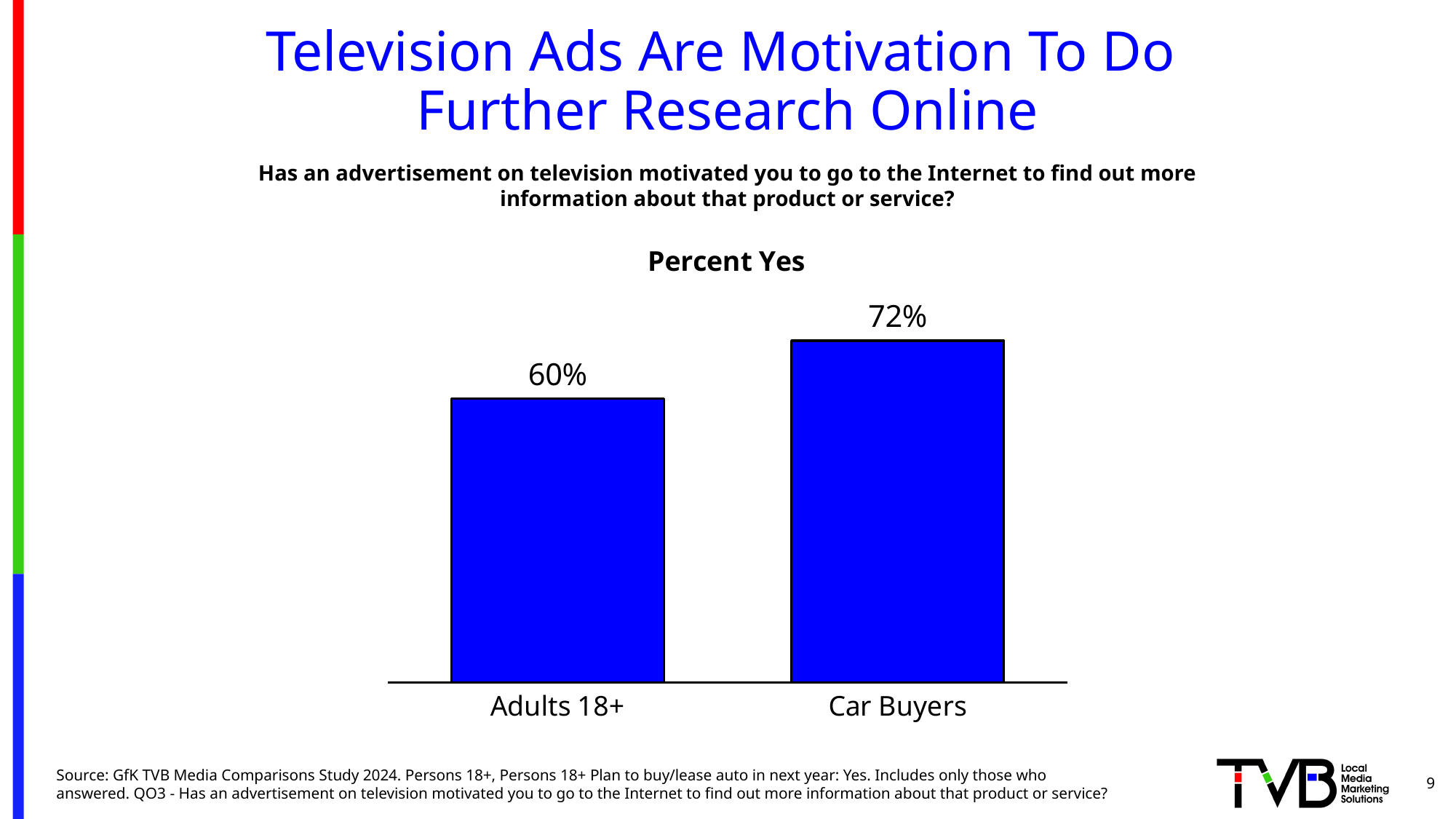
How many categories are shown in the chart? 2 What colour are the bars in the chart? Blue What is the difference between the Percent Yes values for Car Buyers and Adults 18+? 12% Which is larger, the value for Adults 18+ or the value for Car Buyers? Car Buyers What is the Percent Yes value for Car Buyers? 72% What kind of chart is shown on the slide? Bar chart Which category has the lowest Percent Yes value? Adults 18+ Which category has the highest Percent Yes value? Car Buyers What is the title of the chart? Percent Yes What is the Percent Yes value for Adults 18+? 60%